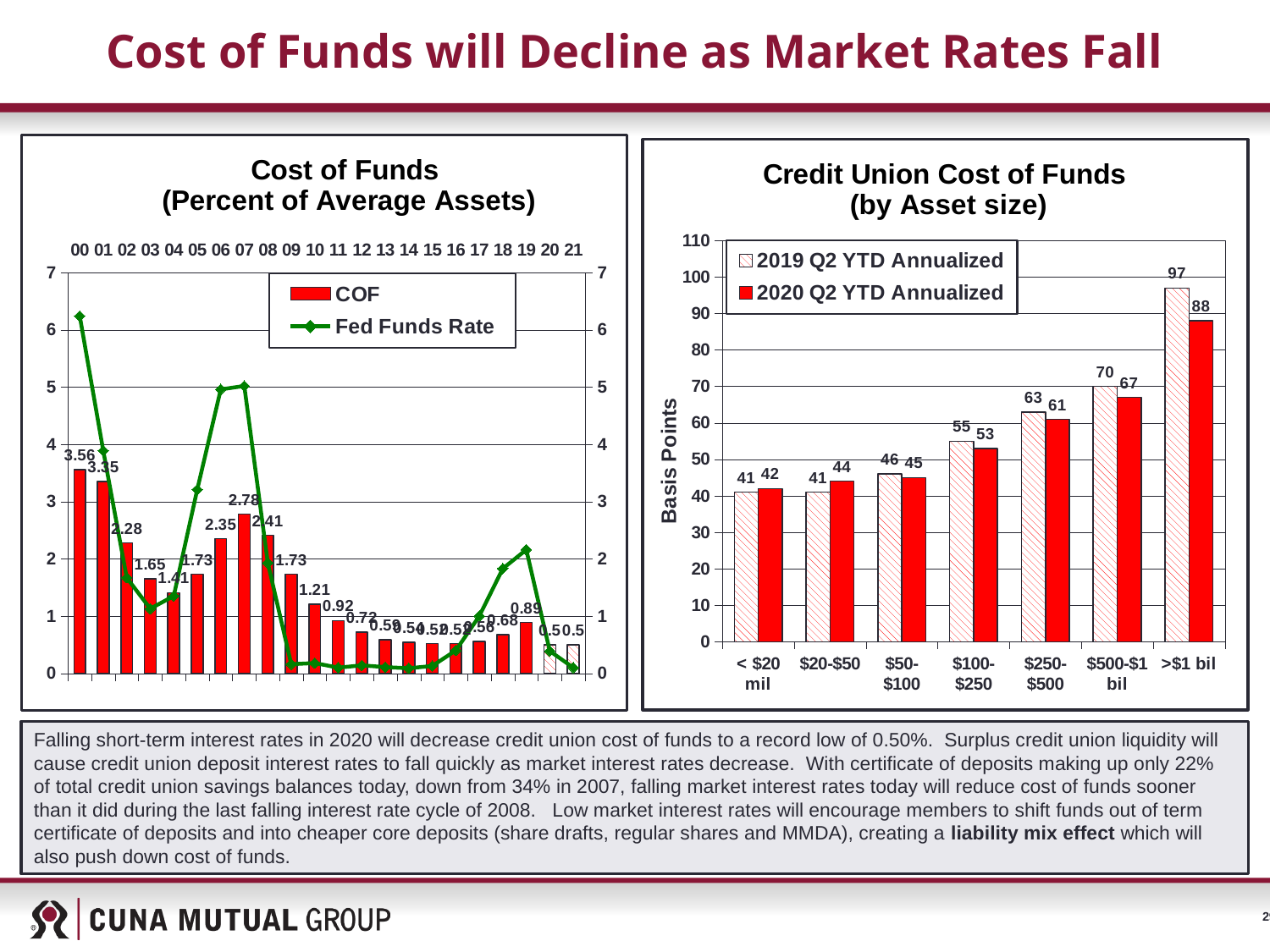
In the 'Credit Union Cost of Funds (by Asset size)' chart, is the 2020 Q2 YTD Annualized value for $500-$1 bil larger or smaller than the 2019 value for the same group? smaller In the 'Credit Union Cost of Funds (by Asset size)' chart, what is the 2020 Q2 YTD Annualized value for the >$1 bil asset group? 88 In the 'Credit Union Cost of Funds (by Asset size)' chart, how many series does the legend list? 2 In the 'Credit Union Cost of Funds (by Asset size)' chart, what is the difference between the 2019 and 2020 Q2 YTD Annualized values for the >$1 bil group? 9 In the 'Cost of Funds (Percent of Average Assets)' chart, what is the COF value for 2000? 3.56 In the 'Cost of Funds (Percent of Average Assets)' chart, what is the COF value for 2007? 2.78 In the 'Credit Union Cost of Funds (by Asset size)' chart, which asset size group has the highest 2019 Q2 YTD Annualized value? >$1 bil In the 'Cost of Funds (Percent of Average Assets)' chart, what is the difference between the COF values for 2019 and 2020? 0.39 In the 'Credit Union Cost of Funds (by Asset size)' chart, what is the 2019 Q2 YTD Annualized value for the $100-$250 asset group? 55 In the 'Cost of Funds (Percent of Average Assets)' chart, what is the y-axis label of the right-hand chart on the slide, 'Credit Union Cost of Funds (by Asset size)'? Basis Points In the 'Credit Union Cost of Funds (by Asset size)' chart, how many asset size categories are shown on the x axis? 7 In the 'Cost of Funds (Percent of Average Assets)' chart, what type of chart is used to show the COF series? Bar chart